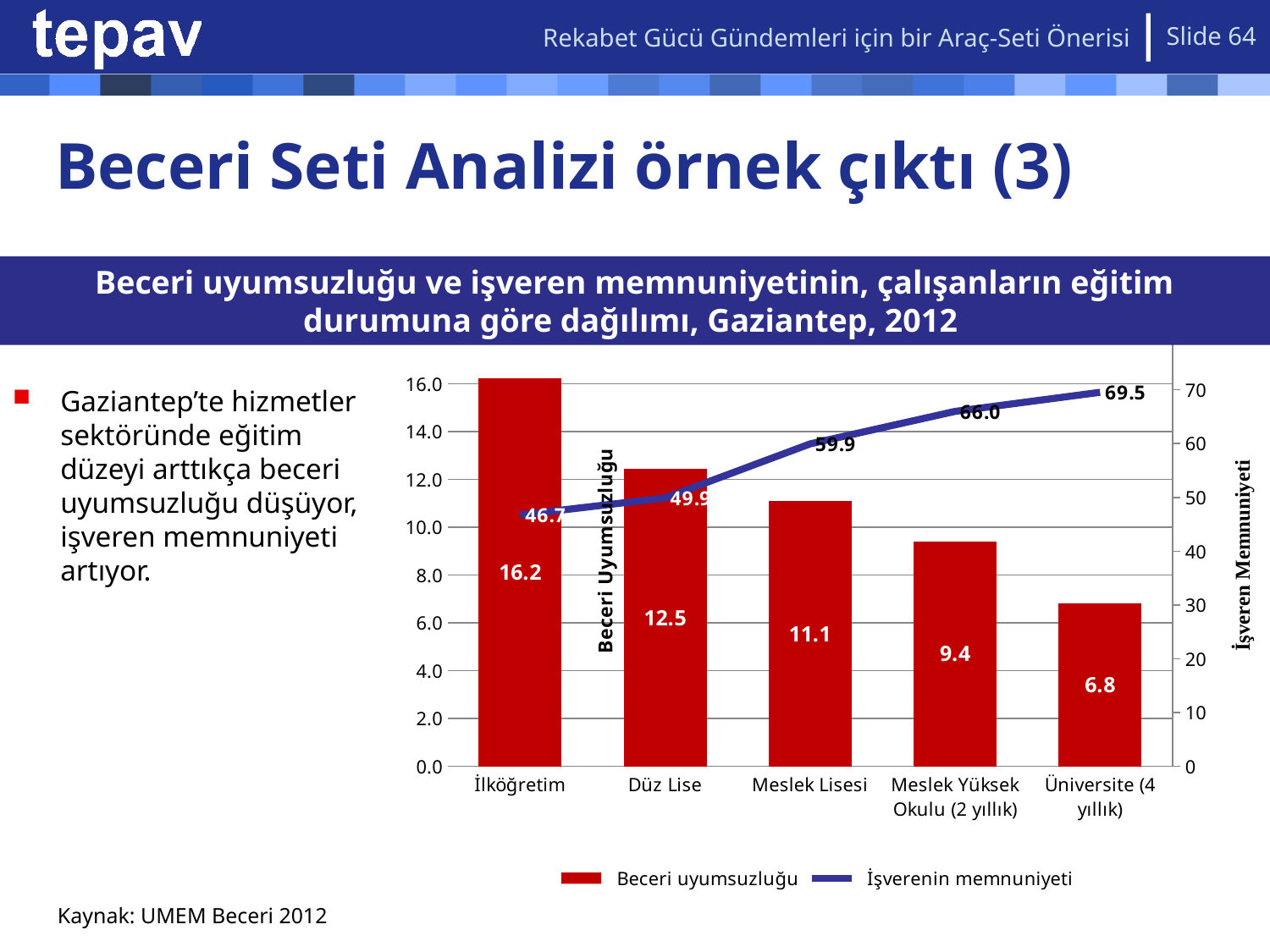
What is the source cited below the chart? UMEM Beceri 2012 How many education categories are shown on the x axis? 5 What is the difference between the Beceri uyumsuzluğu values for İlköğretim and Üniversite (4 yıllık)? 9.4 What is the İşverenin memnuniyeti value for Meslek Lisesi? 59.9 Which category has the highest Beceri uyumsuzluğu value? İlköğretim Which is larger, the İşverenin memnuniyeti value for Düz Lise or for Meslek Yüksek Okulu (2 yıllık)? Meslek Yüksek Okulu (2 yıllık) What is the Beceri uyumsuzluğu value for İlköğretim? 16.2 Does the Beceri uyumsuzluğu series rise or fall from İlköğretim to Üniversite (4 yıllık)? fall Which category has the lowest İşverenin memnuniyeti value? İlköğretim What is the Beceri uyumsuzluğu value for Meslek Yüksek Okulu (2 yıllık)? 9.4 How many series does the legend list? 2 What is the İşverenin memnuniyeti value for Üniversite (4 yıllık)? 69.5